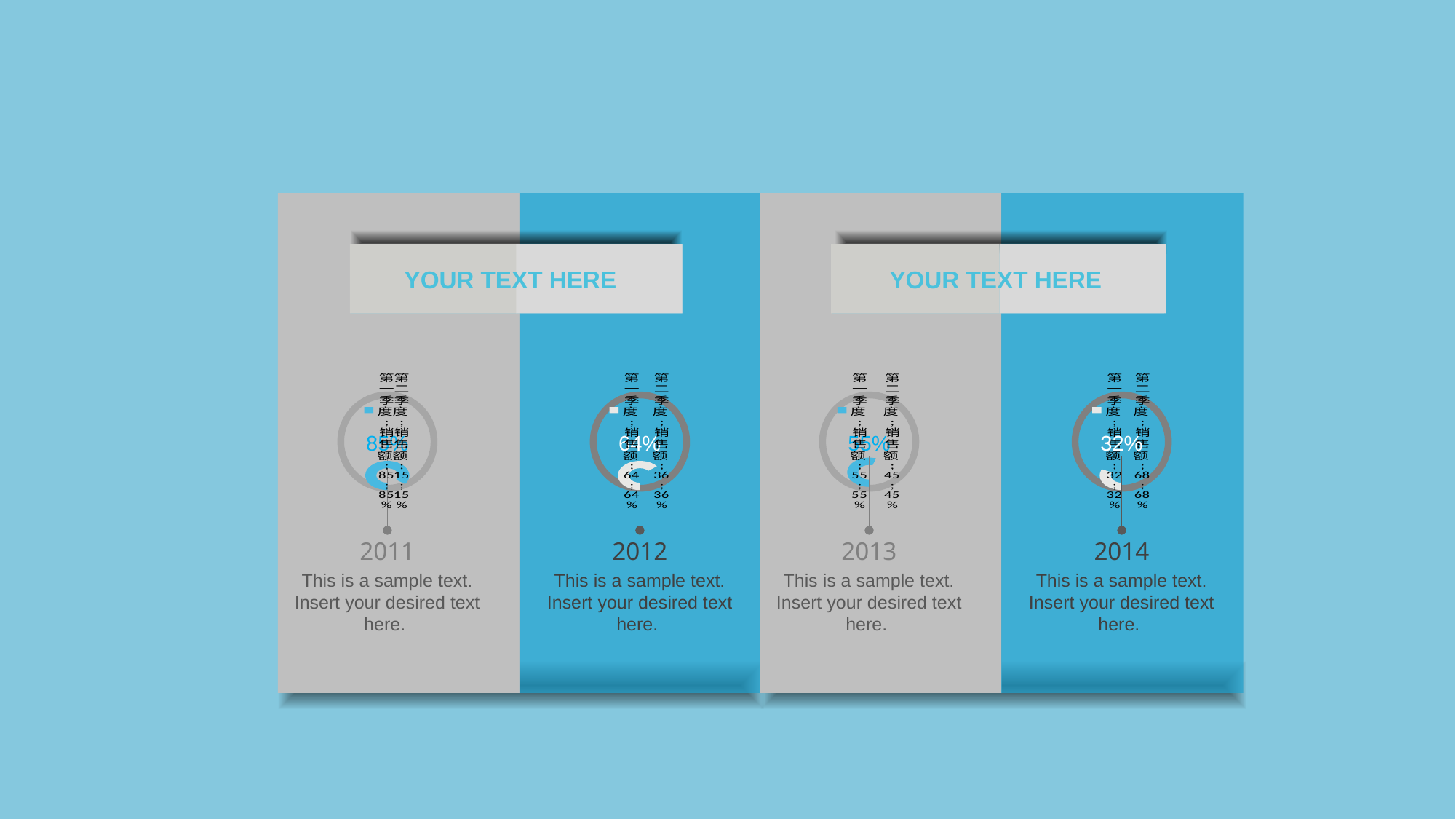
In the chart above 2013, what is the value for 第一季度销售额? 55% In the chart above 2012, what is the difference between 第一季度销售额 and 第二季度销售额? 28% In the chart above 2014, which is larger, 第一季度销售额 or 第二季度销售额? 第二季度销售额 In the chart above 2012, what is the value for 第二季度销售额? 36% In the chart above 2011, what is the difference between 第一季度销售额 and 第二季度销售额? 70% How many categories does the chart above 2013 show? 2 How many charts are on the slide? 4 In the chart above 2011, what is the value for 第二季度销售额? 15% In the chart above 2011, what is the value for 第一季度销售额? 85% In the chart above 2012, what is the value for 第一季度销售额? 64% In the chart above 2014, what is the value for 第二季度销售额? 68% What kind of chart is shown above each year on the slide? Doughnut chart